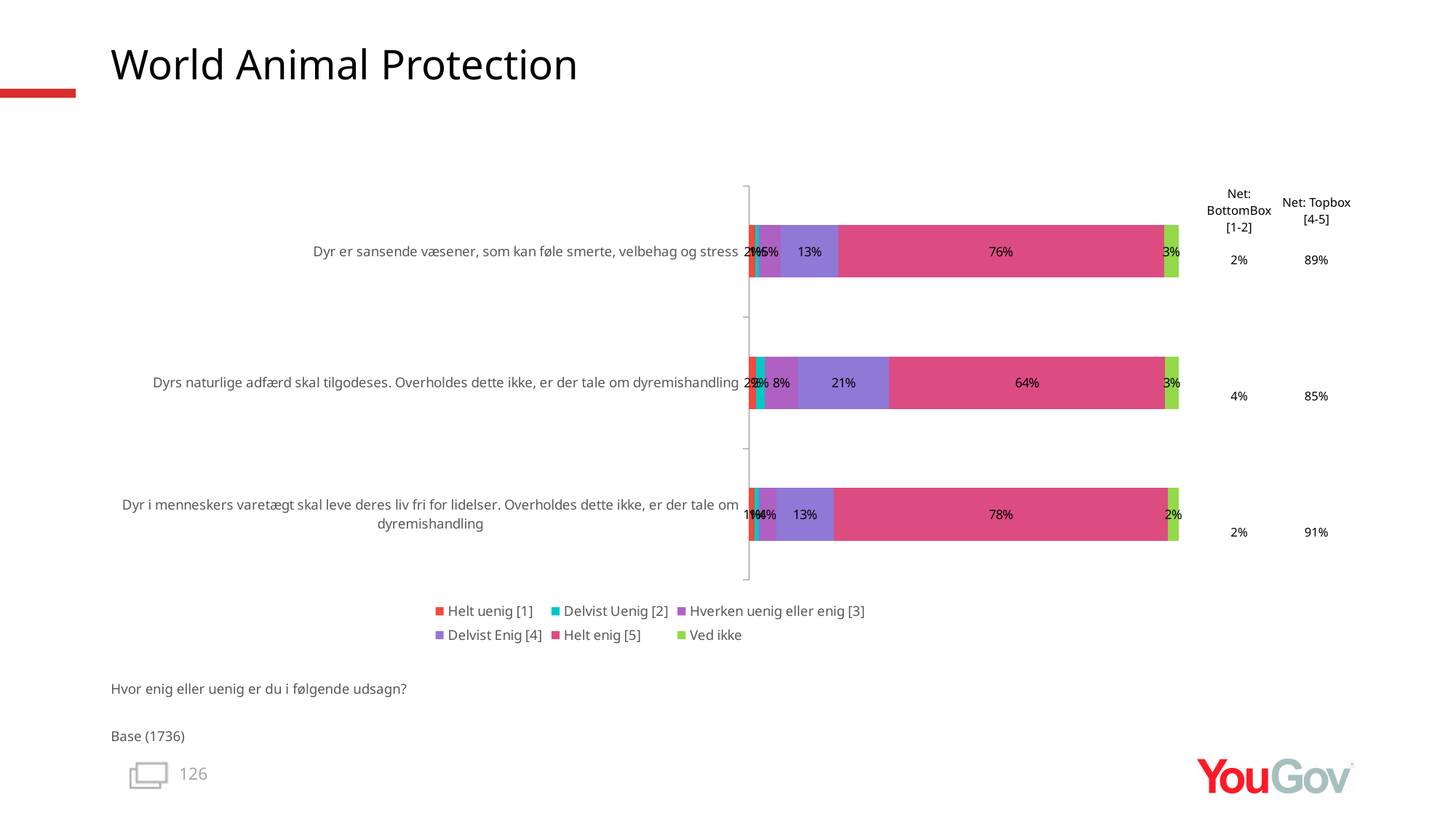
Which statement has the highest 'Helt enig [5]' share? Dyr i menneskers varetægt skal leve deres liv fri for lidelser. Overholdes dette ikke, er der tale om dyremishandling Which is larger: the 'Net: BottomBox [1-2]' value for the second statement or for the third statement? The second statement (4%) What is the 'Delvist Enig [4]' value for the statement 'Dyrs naturlige adfærd skal tilgodeses. Overholdes dette ikke, er der tale om dyremishandling'? 21% How many series does the chart legend list? 6 How many statements (categories) are plotted in the chart? 3 What is the 'Ved ikke' value for the statement 'Dyr i menneskers varetægt skal leve deres liv fri for lidelser. Overholdes dette ikke, er der tale om dyremishandling'? 2% What type of chart is shown on the slide? Stacked bar chart What is the 'Helt enig [5]' value for the statement 'Dyr er sansende væsener, som kan føle smerte, velbehag og stress'? 76% Which statement has the lowest 'Helt enig [5]' share? Dyrs naturlige adfærd skal tilgodeses. Overholdes dette ikke, er der tale om dyremishandling What is the difference between the 'Helt enig [5]' values for the first statement (76%) and the second statement (64%)? 12 percentage points What is the 'Net: Topbox [4-5]' value for the statement 'Dyrs naturlige adfærd skal tilgodeses. Overholdes dette ikke, er der tale om dyremishandling'? 85% What is the 'Helt enig [5]' value for the statement 'Dyr i menneskers varetægt skal leve deres liv fri for lidelser. Overholdes dette ikke, er der tale om dyremishandling'? 78%